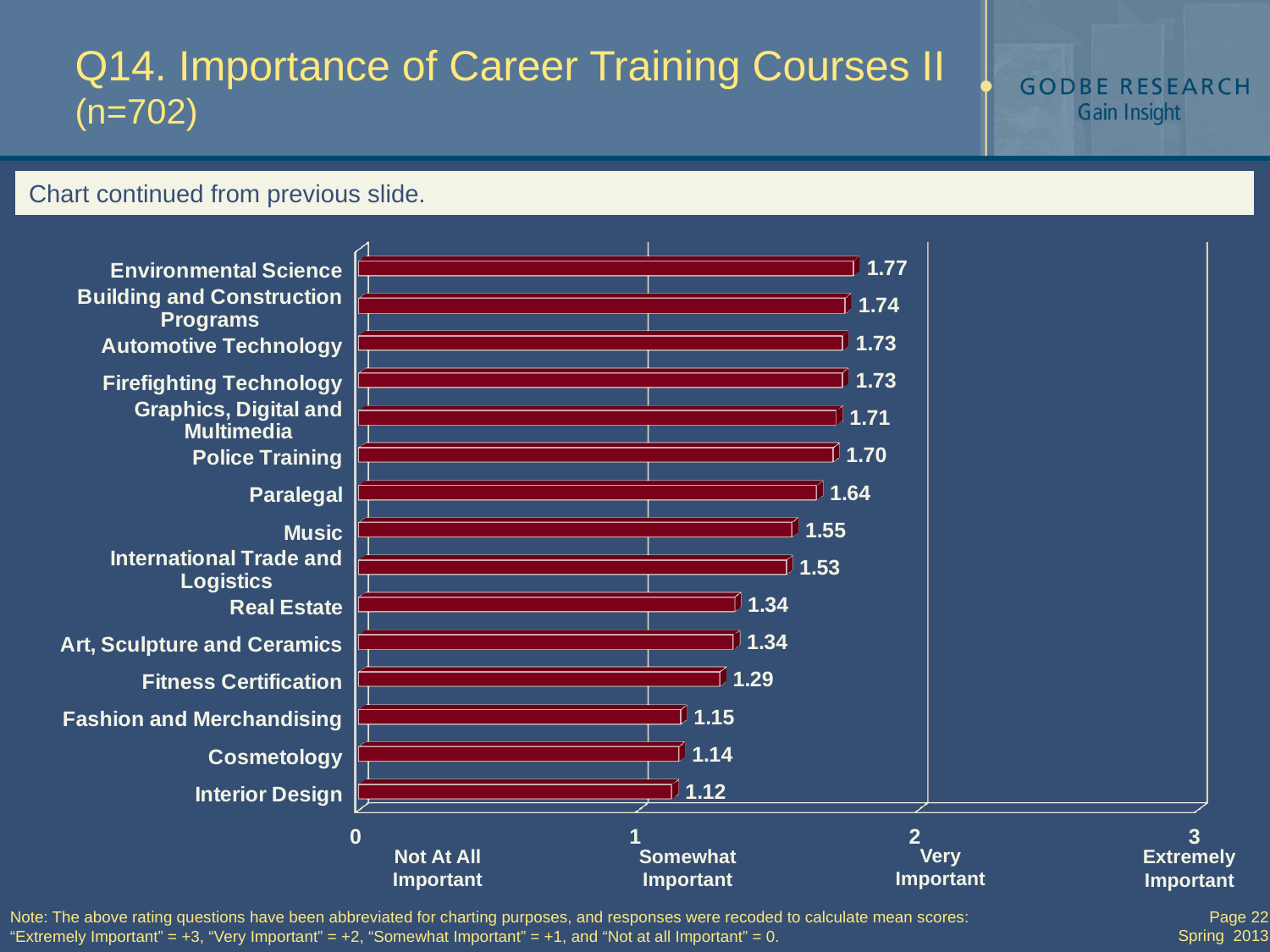
What is the difference between the scores for Environmental Science and Interior Design? 0.65 What kind of chart is shown on the slide? bar chart What is the mean importance score for Environmental Science? 1.77 Which category has the lowest mean importance score? Interior Design What label does the x axis give to the value 2? Very Important Which category has the highest mean importance score? Environmental Science Which has a higher mean score, Cosmetology or Real Estate? Real Estate Is the value for Music greater or less than 1? greater What is the mean importance score for Fitness Certification? 1.29 What is the difference between the scores for Paralegal and Music? 0.09 How many categories are shown in the chart? 15 What is the mean importance score for Police Training? 1.70